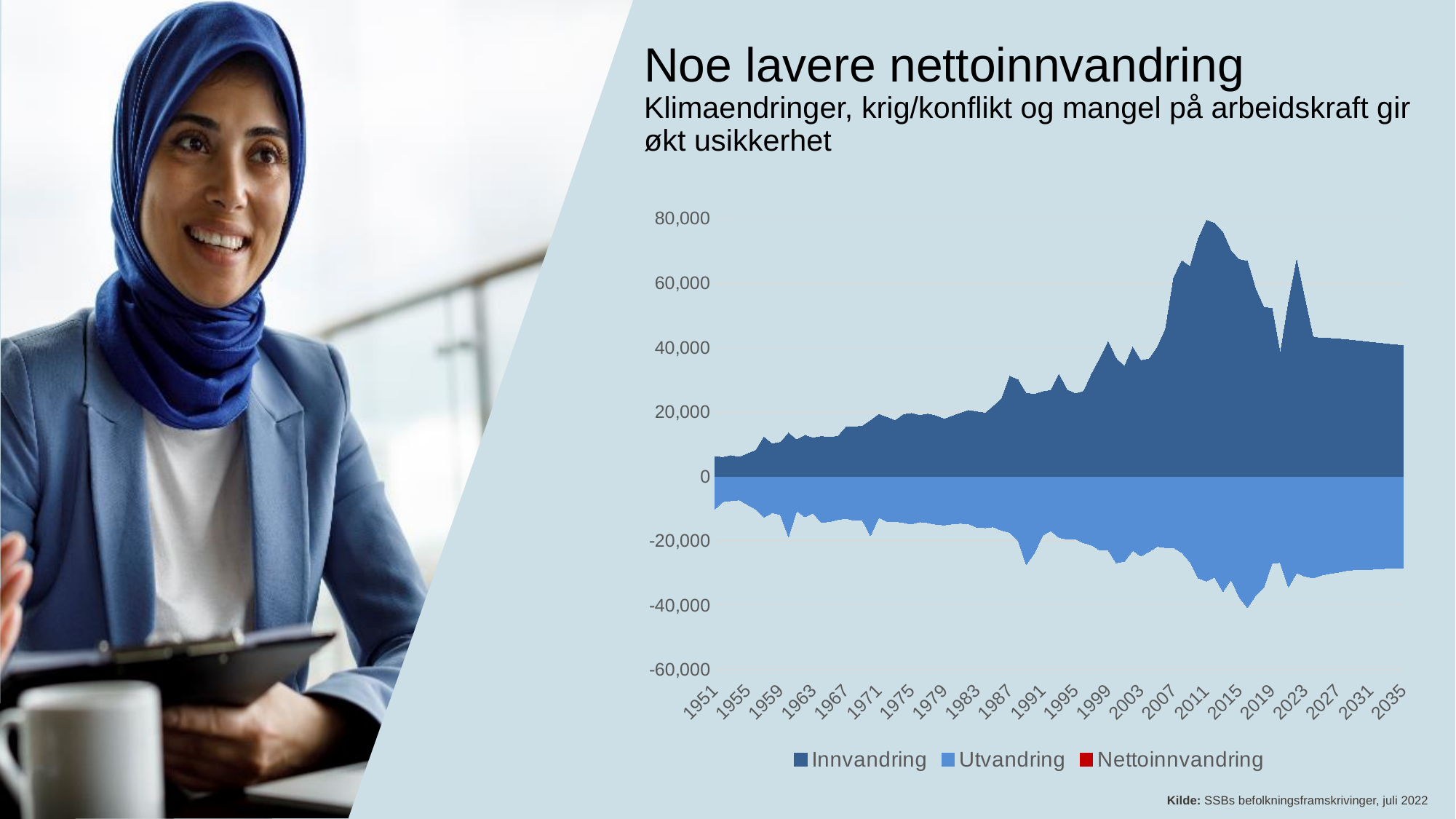
What kind of chart is shown on the slide? area chart What is the title of the slide containing the chart? Noe lavere nettoinnvandring Is the Innvandring value in 1951 greater or less than 20,000? less How many year labels are shown on the x axis of the chart? 22 How many series does the chart legend list? 3 Is the Utvandring value in 1951 greater or less than -20,000? greater What is the lowest value shown on the y axis of the chart? -60,000 Is the Utvandring value around 2017 greater or less than -20,000? less Which colour does the legend use for Nettoinnvandring? red Does the Innvandring series generally rise or fall from 1951 to 2011? rise